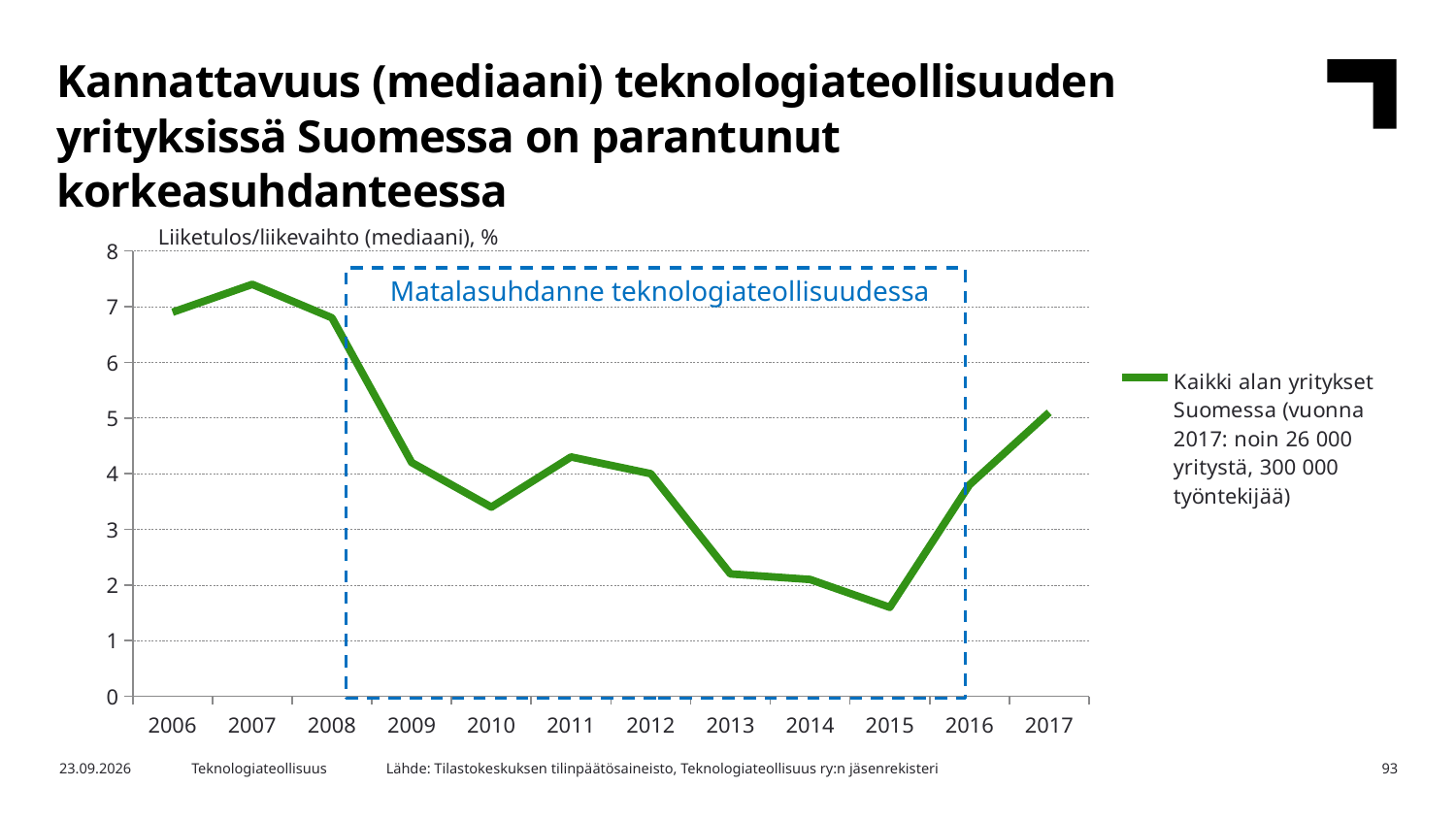
Is the value for 2015 greater or less than 2? less In which year is the median operating profit/turnover highest? 2007 Which year has the larger value, 2008 or 2009? 2008 What kind of chart is shown on the slide? Line chart How many years are plotted on the x axis of the chart? 12 Is the value for 2007 greater or less than 7? greater Which year has the larger value, 2016 or 2017? 2017 Is the value for 2010 greater or less than 4? less In which year is the median operating profit/turnover lowest? 2015 How many series does the chart's legend list? 1 Do the values rise or fall from 2015 to 2017? rise What is the axis title shown above the chart? Liiketulos/liikevaihto (mediaani), %